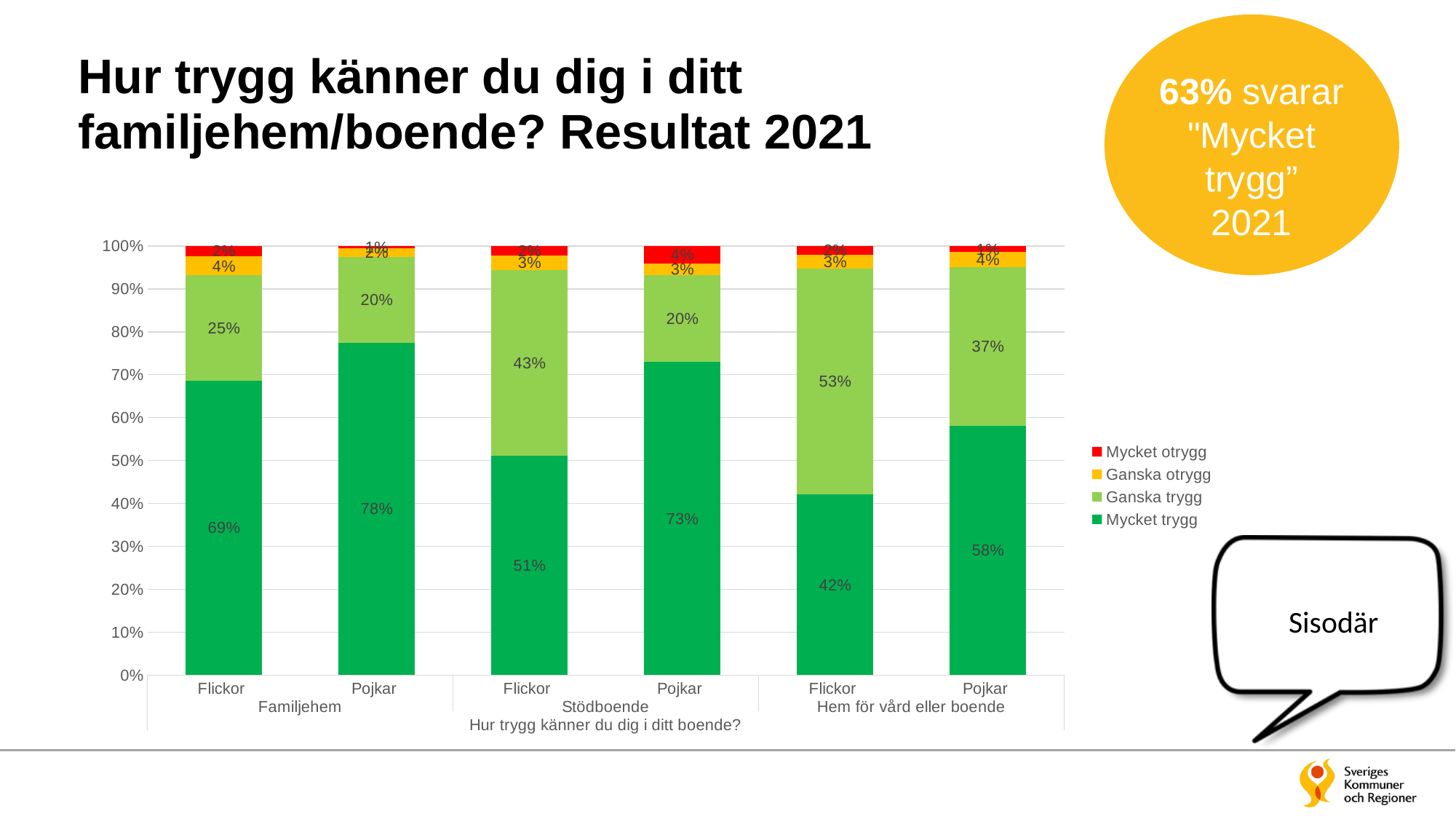
What is the difference between the "Mycket trygg" values for Pojkar and Flickor in Hem för vård eller boende? 16 percentage points Which is larger: the "Ganska trygg" value for Flickor in Stödboende or for Pojkar in Stödboende? Flickor in Stödboende Which bar has the highest "Mycket trygg" share? Pojkar, Familjehem Which bar has the lowest "Mycket trygg" share? Flickor, Hem för vård eller boende What kind of chart is shown on the slide? stacked bar chart How many bars are plotted in the chart? 6 What is the "Mycket trygg" value for Flickor in Stödboende? 51% What is the "Mycket trygg" value for Pojkar in Familjehem? 78% What is the "Ganska trygg" value for Flickor in Hem för vård eller boende? 53% How many series does the chart legend list? 4 Which legend entry is shown in red? Mycket otrygg What is the "Mycket otrygg" value for Pojkar in Stödboende? 4%